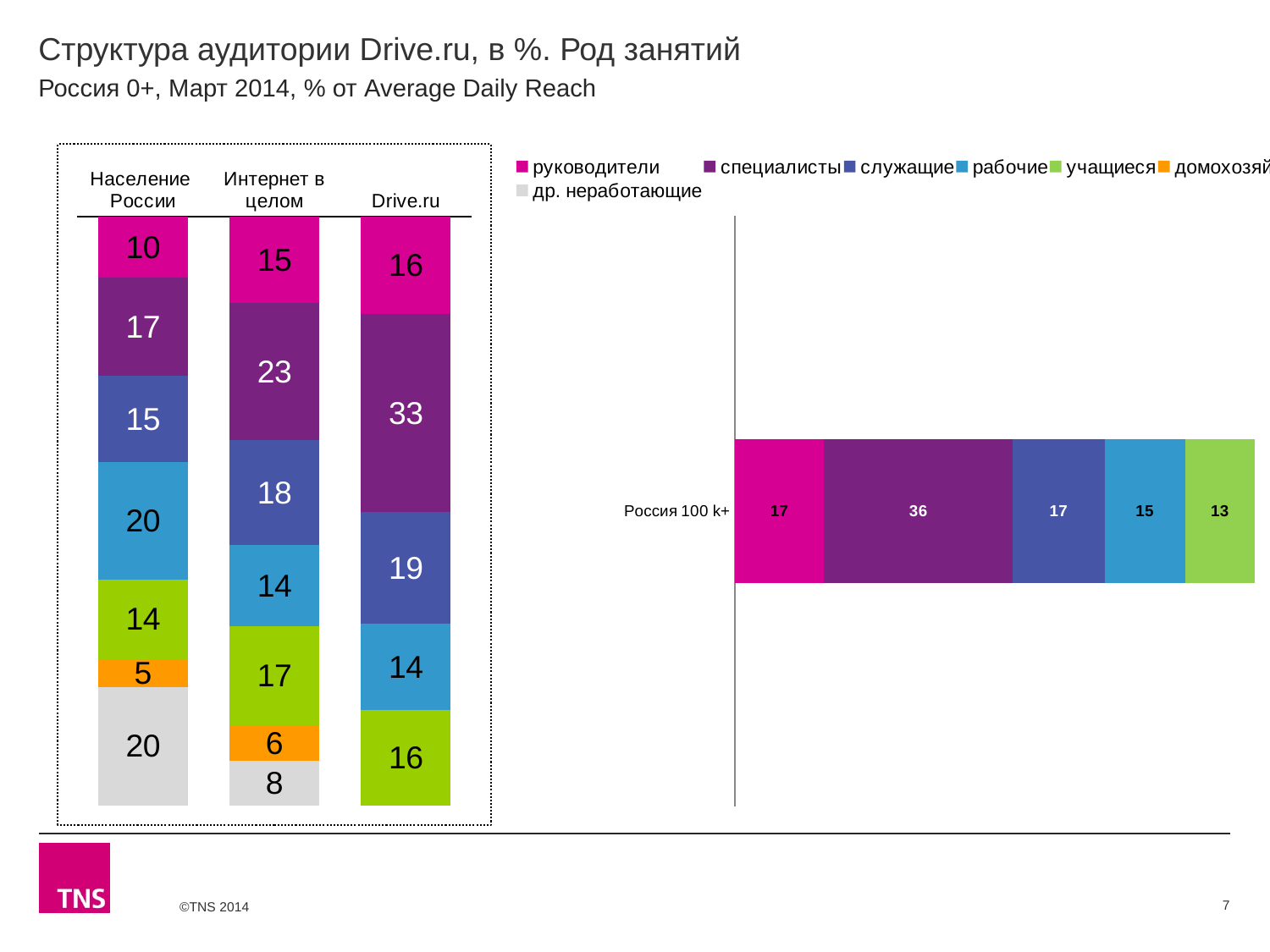
In the left chart, which segment is the largest in the Drive.ru bar? специалисты In the left chart, what is the value for рабочие in the Население России bar? 20 In the left chart, what is the value for специалисты in the Drive.ru bar? 33 In the left chart, what is the difference between the специалисты values for Drive.ru and Население России? 16 In the right chart, what is the value for специалисты in the Россия 100 k+ bar? 36 What kind of chart is the right chart? Stacked bar chart How many series does the legend list? 7 In the right chart, what is the total of the Россия 100 k+ stacked bar? 98 In the left chart, what is the value for домохозяйки in the Интернет в целом bar? 6 In the left chart, which is larger: руководители for Drive.ru or руководители for Население России? Drive.ru In the left chart, which segment is the smallest in the Население России bar? домохозяйки How many bars (categories) does the left chart show? 3